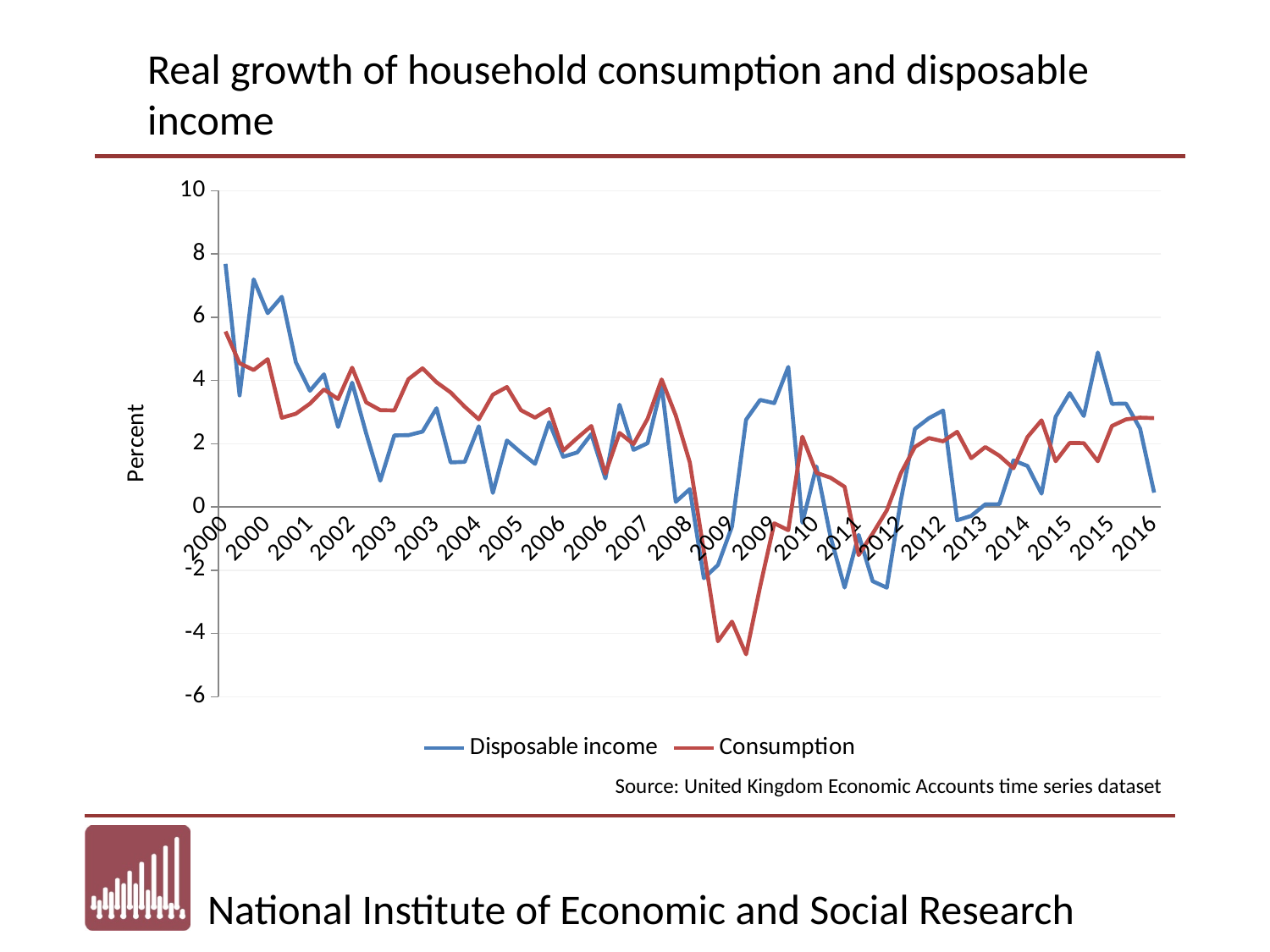
What is the label on the vertical axis? Percent Which series reaches the lowest value anywhere on the chart? Consumption Does the Disposable income line overall rise or fall from 2000 to 2016? fall Is the lowest value reached by the Consumption line (in 2009) greater or less than -4? less Is the value for Disposable income at the first point (2000) greater or less than 6? greater How many series does the legend list? 2 Which series reaches the highest value anywhere on the chart? Disposable income Is the value for Consumption at the last point (2016) greater or less than 2? greater What are the two series named in the legend? Disposable income and Consumption What kind of chart is shown on the slide? line chart At the last point (2016), which series has the higher value, Disposable income or Consumption? Consumption